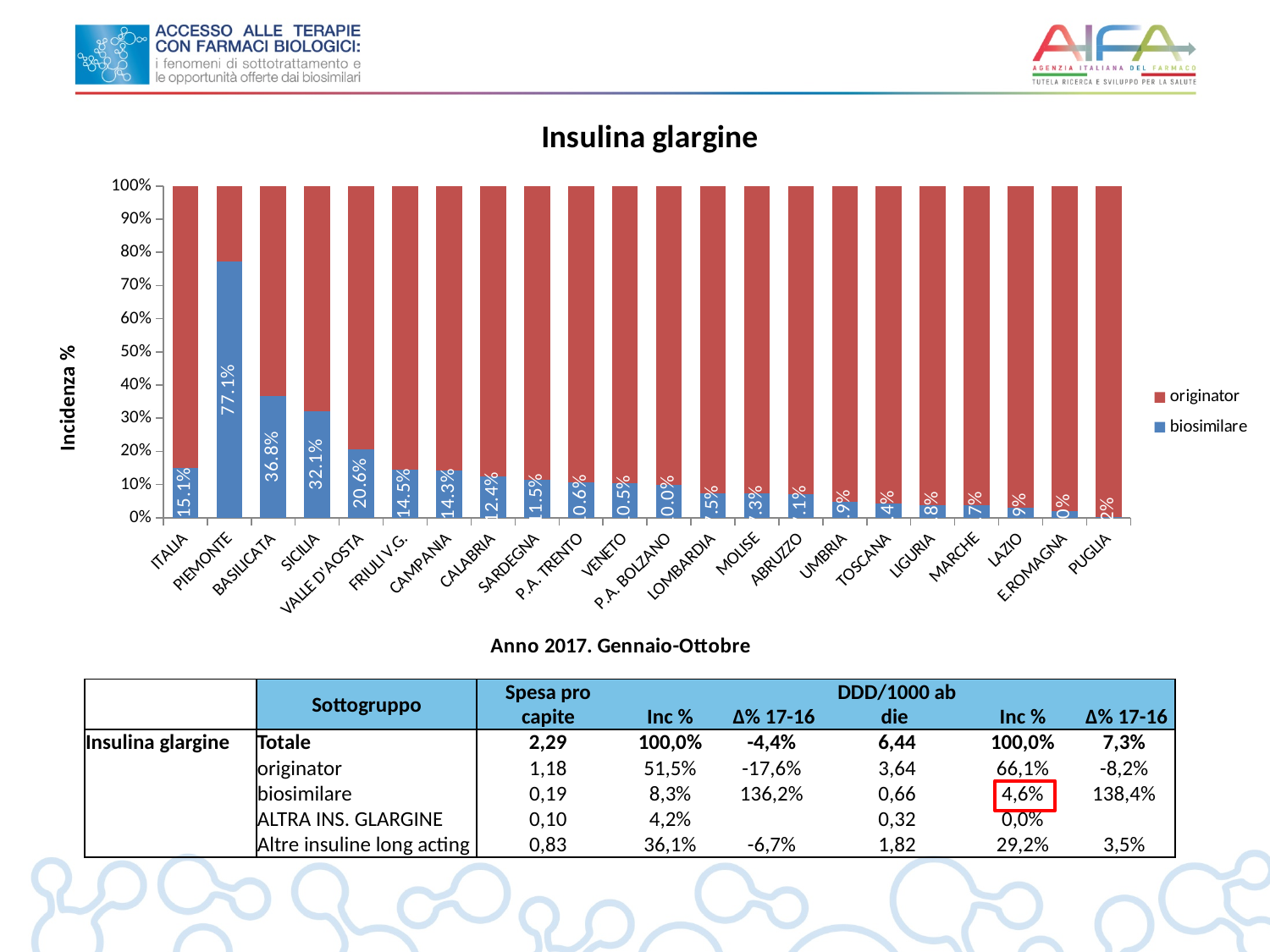
What is the difference between the biosimilare shares of PIEMONTE and BASILICATA? 40.3% Which region has the lowest biosimilare share? PUGLIA Which has a larger biosimilare share, SICILIA or VALLE D'AOSTA? SICILIA What kind of chart is shown on the slide? Stacked bar chart How many regions/categories are shown on the x axis? 22 Which region has the highest biosimilare share? PIEMONTE Is the originator share for PIEMONTE greater or less than 30%? less How many series does the legend list? 2 What is the biosimilare share for VALLE D'AOSTA? 20.6% What is the biosimilare share for ITALIA? 15.1% What is the biosimilare share for BASILICATA? 36.8% What is the biosimilare share for PIEMONTE in the Insulina glargine chart? 77.1%